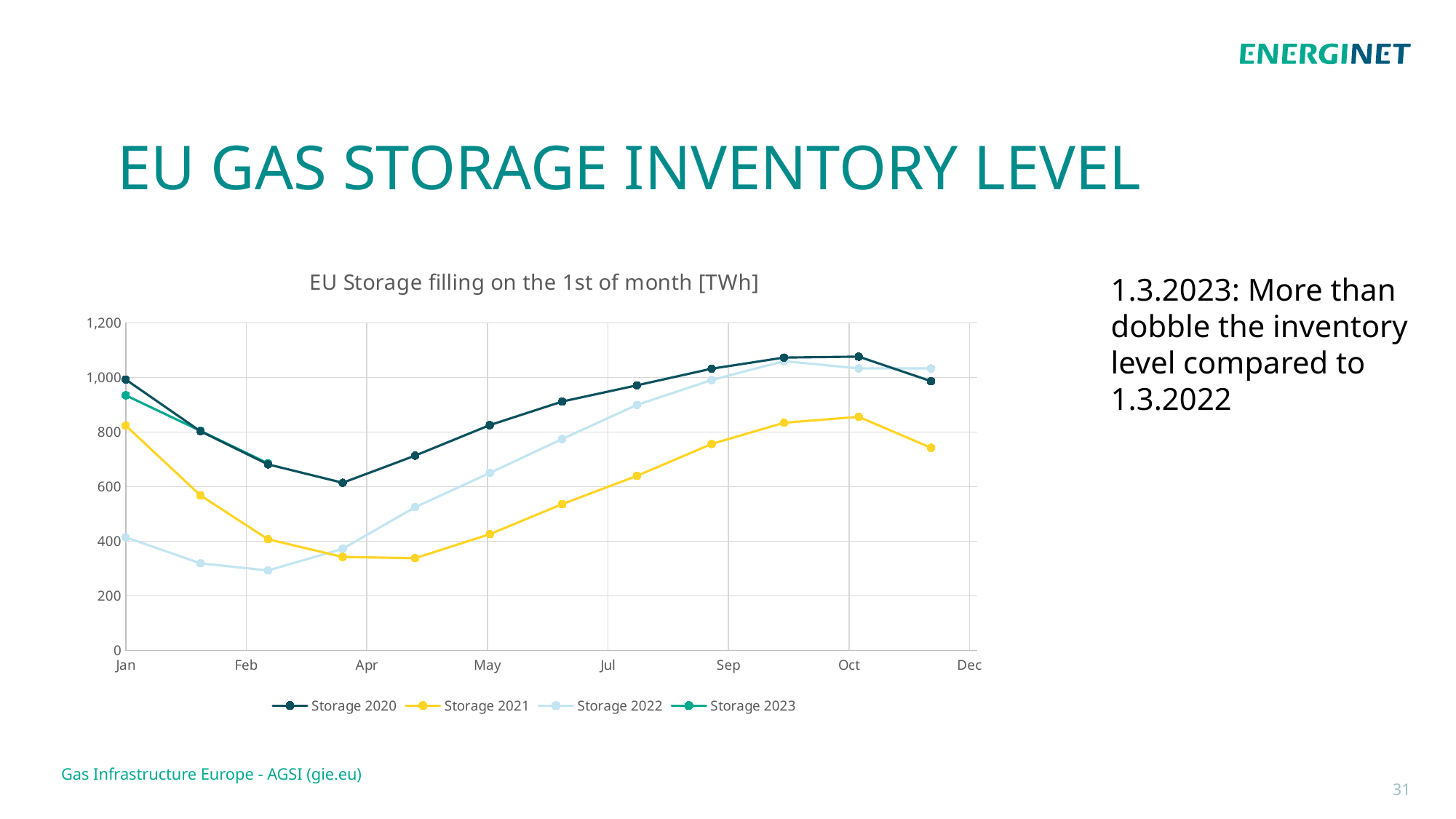
In Jan, which series has the higher value: Storage 2020 or Storage 2022? Storage 2020 What kind of chart is shown on the slide? Line chart Which series is drawn in yellow? Storage 2021 In Dec, which series has the higher value: Storage 2021 or Storage 2022? Storage 2022 Is the value for Storage 2022 in Jan greater or less than 600? less Is the value for Storage 2021 in Dec greater or less than 600? greater Does the Storage 2021 line rise or fall from Apr to Oct? Rises Is the value for Storage 2020 in Jan greater or less than 800? greater What is the title of the chart? EU Storage filling on the 1st of month [TWh] How many series does the legend list? 4